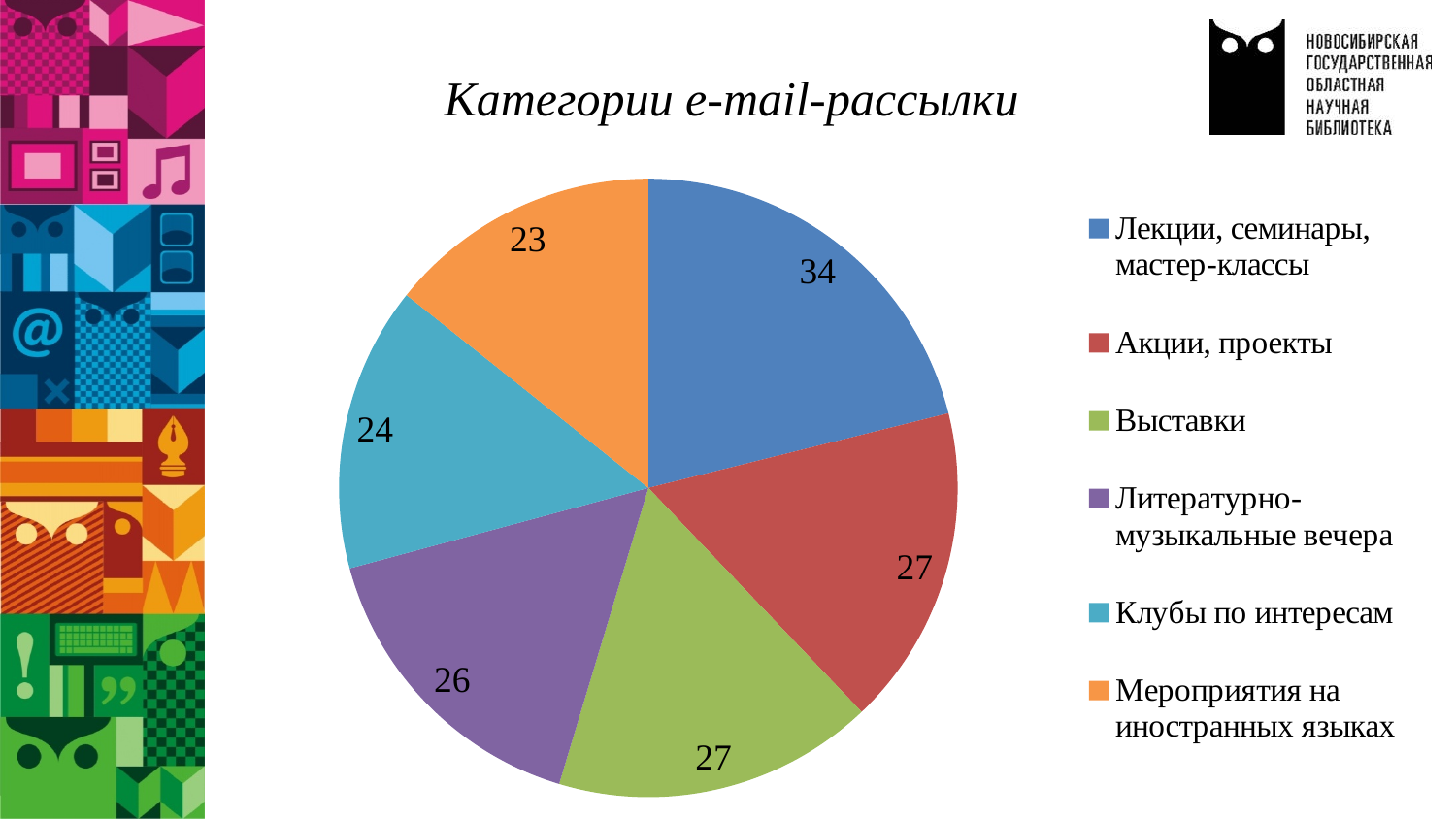
What is the title of the chart? Категории e-mail-рассылки Which category has the largest slice? Лекции, семинары, мастер-классы What type of chart is shown on the slide? Pie chart Which is larger: the value for "Литературно-музыкальные вечера" or for "Клубы по интересам"? Литературно-музыкальные вечера How many categories does the pie chart have? 6 What is the value for "Лекции, семинары, мастер-классы"? 34 What is the value for "Клубы по интересам"? 24 What is the value for "Литературно-музыкальные вечера"? 26 What is the value for "Мероприятия на иностранных языках"? 23 What colour is the slice for "Выставки"? Green Which category has the smallest slice? Мероприятия на иностранных языках What is the difference between the values for "Лекции, семинары, мастер-классы" and "Мероприятия на иностранных языках"? 11